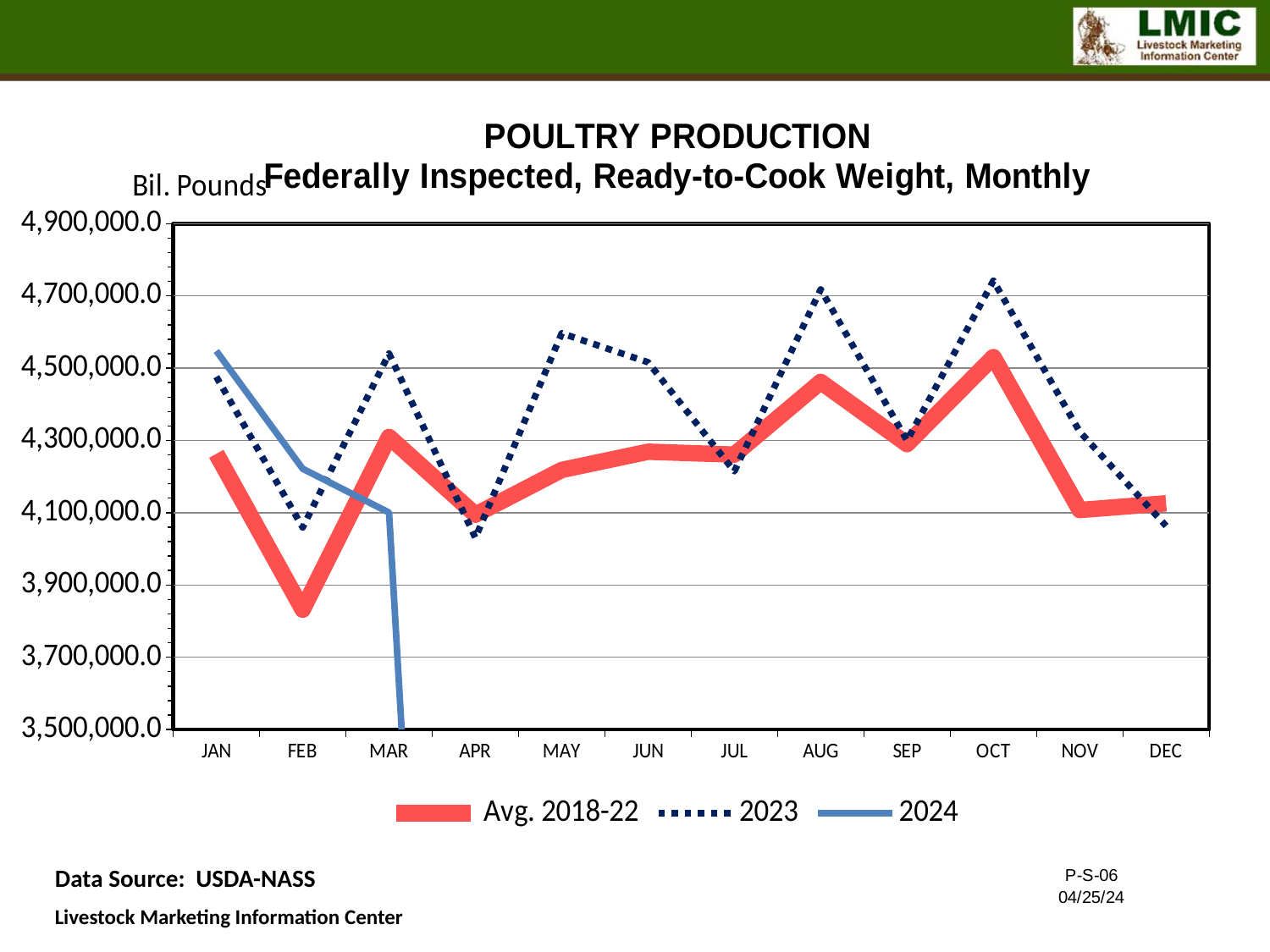
How many months are shown along the x axis? 12 Is the Avg. 2018-22 value for AUG greater or less than 4,500,000.0? less What unit label is shown at the top of the y axis? Bil. Pounds Is the 2024 value for JAN greater or less than 4,500,000.0? greater Does the 2024 line rise or fall from JAN to MAR? fall How many series does the legend list? 3 Is the Avg. 2018-22 value for FEB greater or less than 3,900,000.0? less What kind of chart is shown on the slide? line chart In which month is the Avg. 2018-22 series at its lowest? FEB In which month is the Avg. 2018-22 series at its highest? OCT In JAN, which is higher: the 2024 value or the Avg. 2018-22 value? 2024